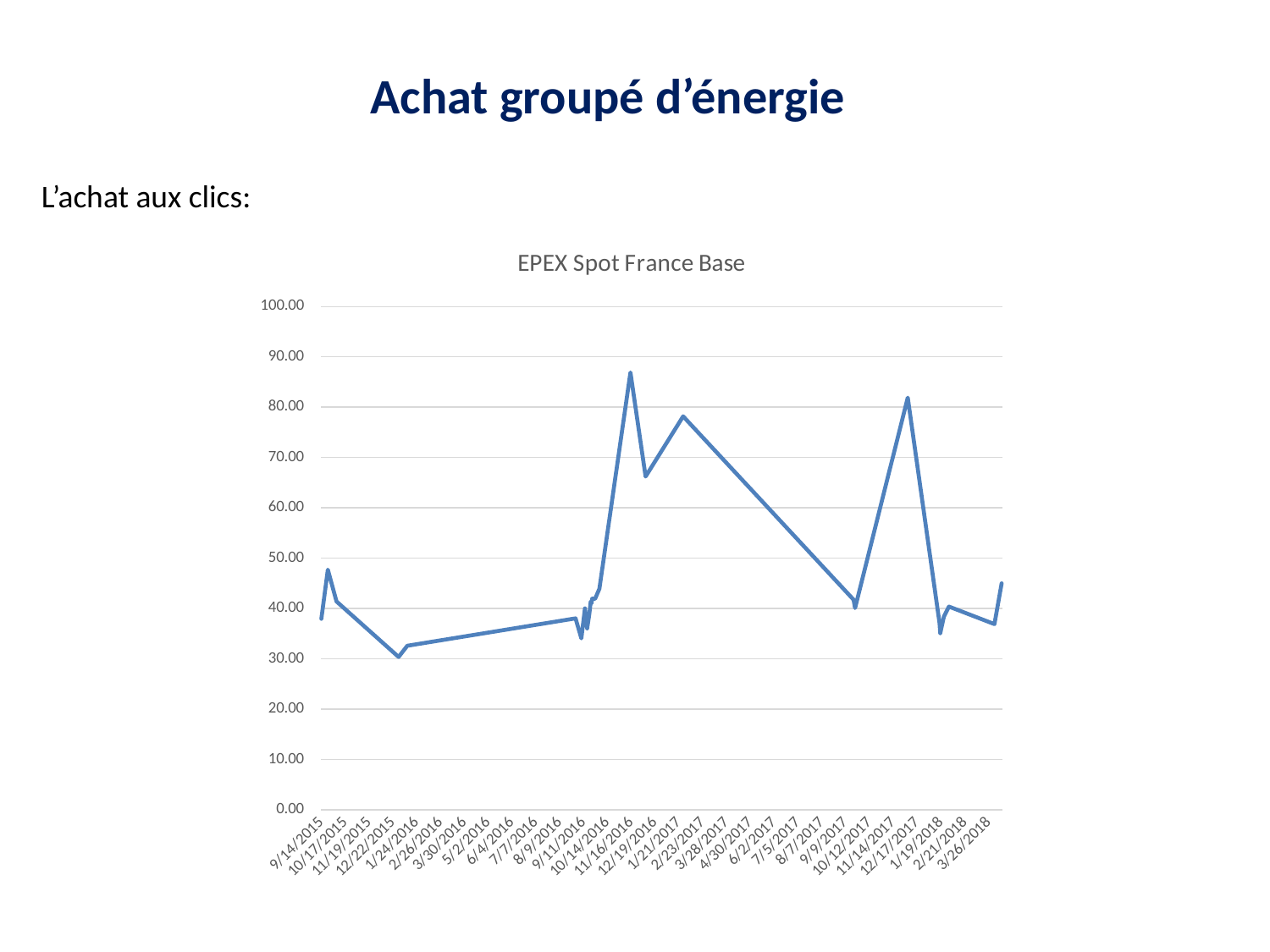
What is the highest value shown on the vertical axis of the chart? 100.00 Is the value around 12/22/2015 greater or less than 40? less Is the value around 1/21/2017 greater or less than 60? greater Is the peak value of the line in late 2016 greater or less than 80? greater What is the title of the chart? EPEX Spot France Base Is the value around 9/14/2015 larger or smaller than the peak value in late 2016? smaller What kind of chart is shown on the slide? line chart Does the line rise or fall between 12/22/2015 and 8/9/2016? rise Does the line rise or fall between 2/23/2017 and 9/9/2017? fall